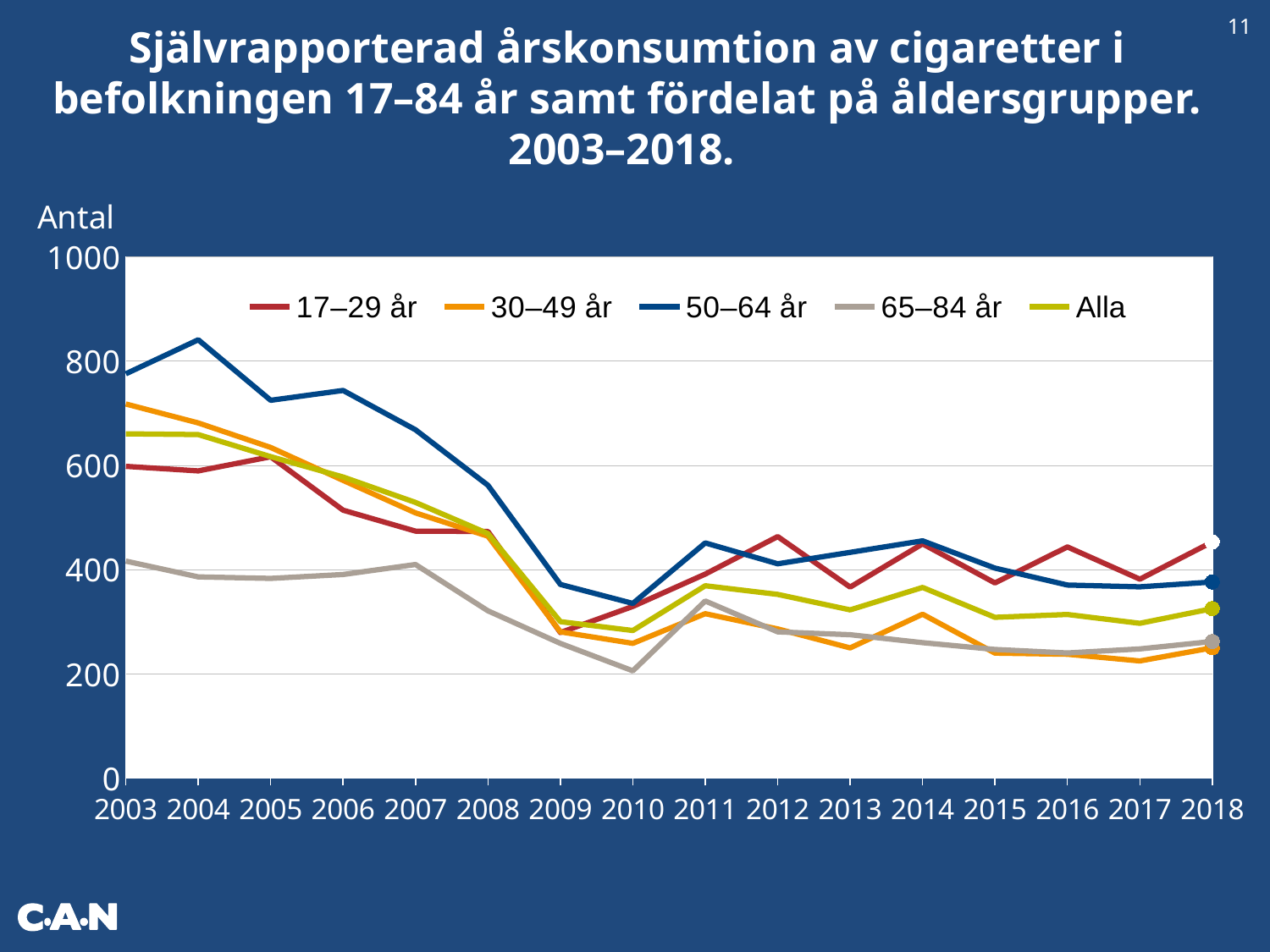
In 2003, which is larger: the value for 50–64 år or the value for 17–29 år? 50–64 år Is the value for 50–64 år in 2004 greater or less than 800? greater What kind of chart is shown on the slide? Line chart Is the value for 30–49 år in 2003 greater or less than 600? greater Does the value for Alla rise or fall from 2003 to 2009? Fall How many series does the legend list? 5 What label is shown on the vertical axis? Antal How many years are plotted along the x axis? 16 Which age group has the lowest value in 2010? 65–84 år Is the value for 65–84 år in 2010 greater or less than 400? less Which age group has the highest value in 2018? 17–29 år Which age group has the highest value in 2004? 50–64 år